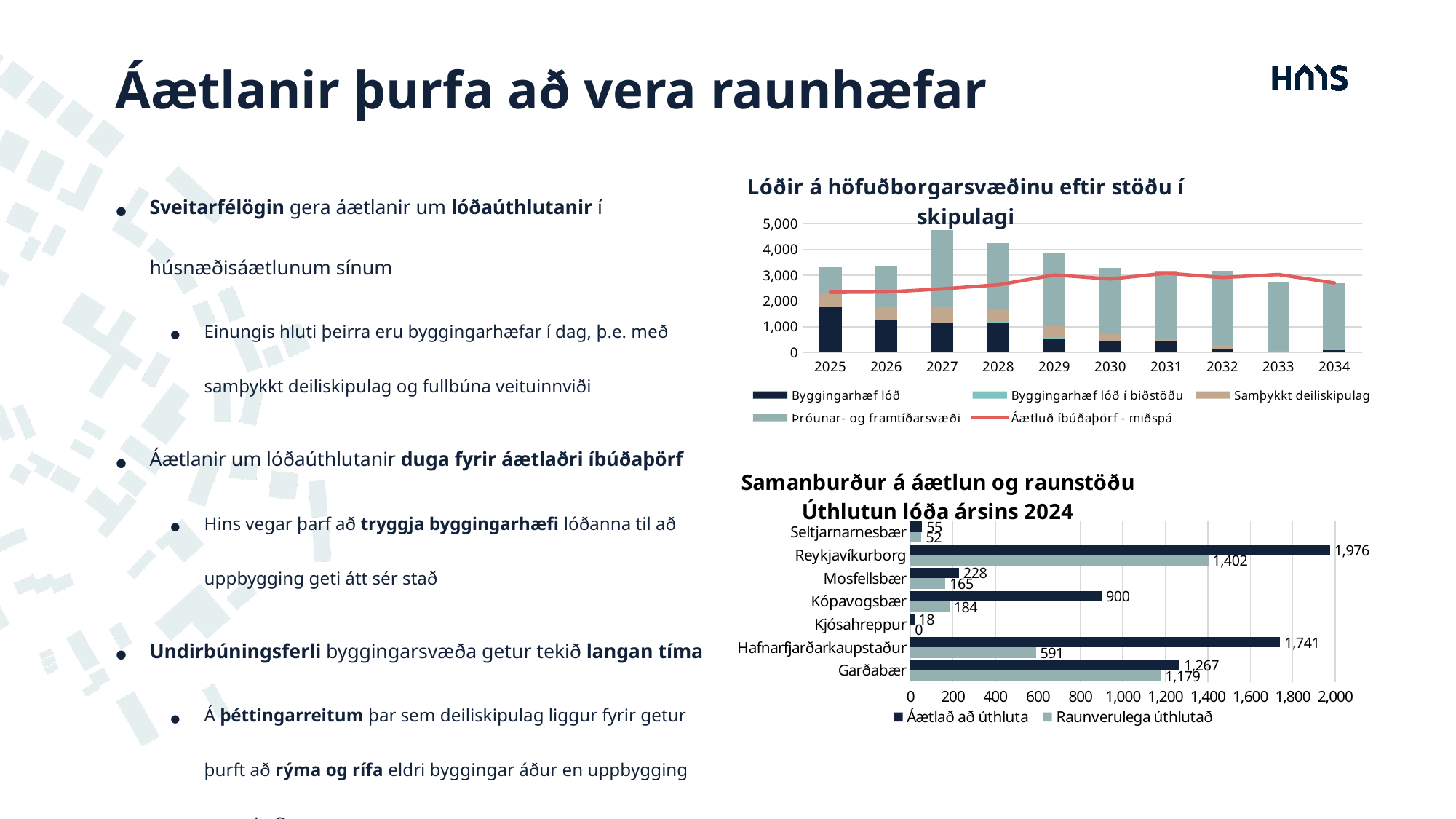
In the bottom chart 'Úthlutun lóða ársins 2024', how many municipalities are shown? 7 In the top chart 'Lóðir á höfuðborgarsvæðinu eftir stöðu í skipulagi', how many years are shown on the x axis? 10 In the bottom chart 'Úthlutun lóða ársins 2024', how many series does the legend list? 2 In the bottom chart 'Úthlutun lóða ársins 2024', what is the value of 'Raunverulega úthlutað' for Hafnarfjarðarkaupstaður? 591 In the bottom chart 'Úthlutun lóða ársins 2024', what is the value of 'Áætlað að úthluta' for Reykjavíkurborg? 1,976 In the bottom chart 'Úthlutun lóða ársins 2024', what is the difference between 'Áætlað að úthluta' and 'Raunverulega úthlutað' for Kópavogsbær? 716 In the bottom chart 'Úthlutun lóða ársins 2024', which is larger for Garðabær: 'Áætlað að úthluta' or 'Raunverulega úthlutað'? Áætlað að úthluta In the bottom chart 'Úthlutun lóða ársins 2024', which municipality has the highest 'Áætlað að úthluta' value? Reykjavíkurborg In the bottom chart 'Úthlutun lóða ársins 2024', which municipality has the lowest 'Raunverulega úthlutað' value? Kjósahreppur What kind of chart is the top chart 'Lóðir á höfuðborgarsvæðinu eftir stöðu í skipulagi'? Stacked bar chart with a line In the top chart 'Lóðir á höfuðborgarsvæðinu eftir stöðu í skipulagi', is the total bar height for 2027 greater or less than 4,000? greater In the top chart 'Lóðir á höfuðborgarsvæðinu eftir stöðu í skipulagi', how many entries does the legend list? 5